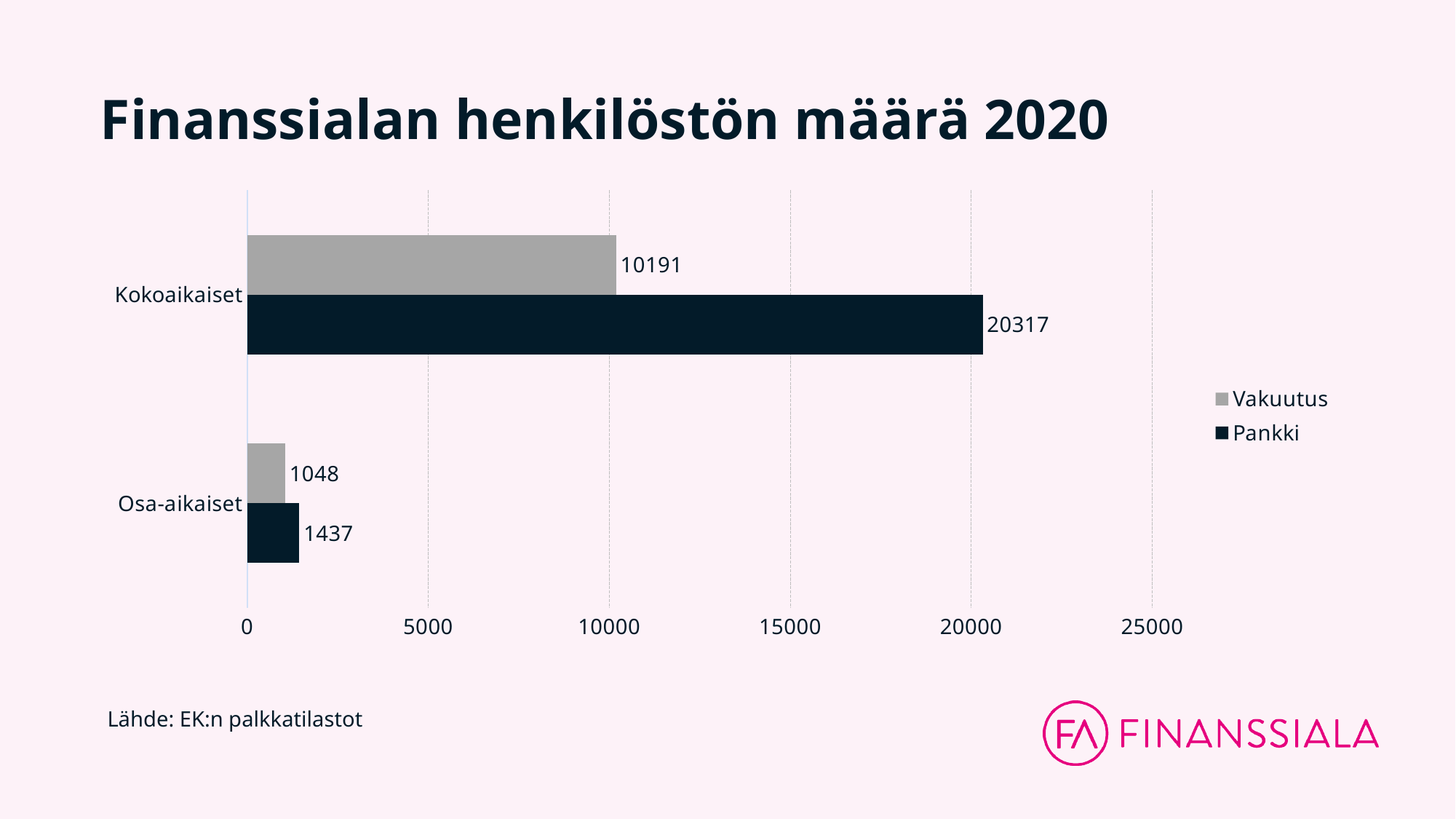
What is the Vakuutus value for Osa-aikaiset? 1048 What is the title of the chart? Finanssialan henkilöstön määrä 2020 What is the difference between the Pankki and Vakuutus values for Osa-aikaiset? 389 How many series does the legend list? 2 Which bar has the lowest value on the chart? Vakuutus, Osa-aikaiset What is the Vakuutus value for Kokoaikaiset? 10191 What is the Pankki value for Osa-aikaiset? 1437 Which bar has the highest value on the chart? Pankki, Kokoaikaiset What kind of chart is shown on the slide? Bar chart Which is larger for Osa-aikaiset, Vakuutus or Pankki? Pankki What is the Pankki value for Kokoaikaiset? 20317 What is the difference between the Pankki and Vakuutus values for Kokoaikaiset? 10126